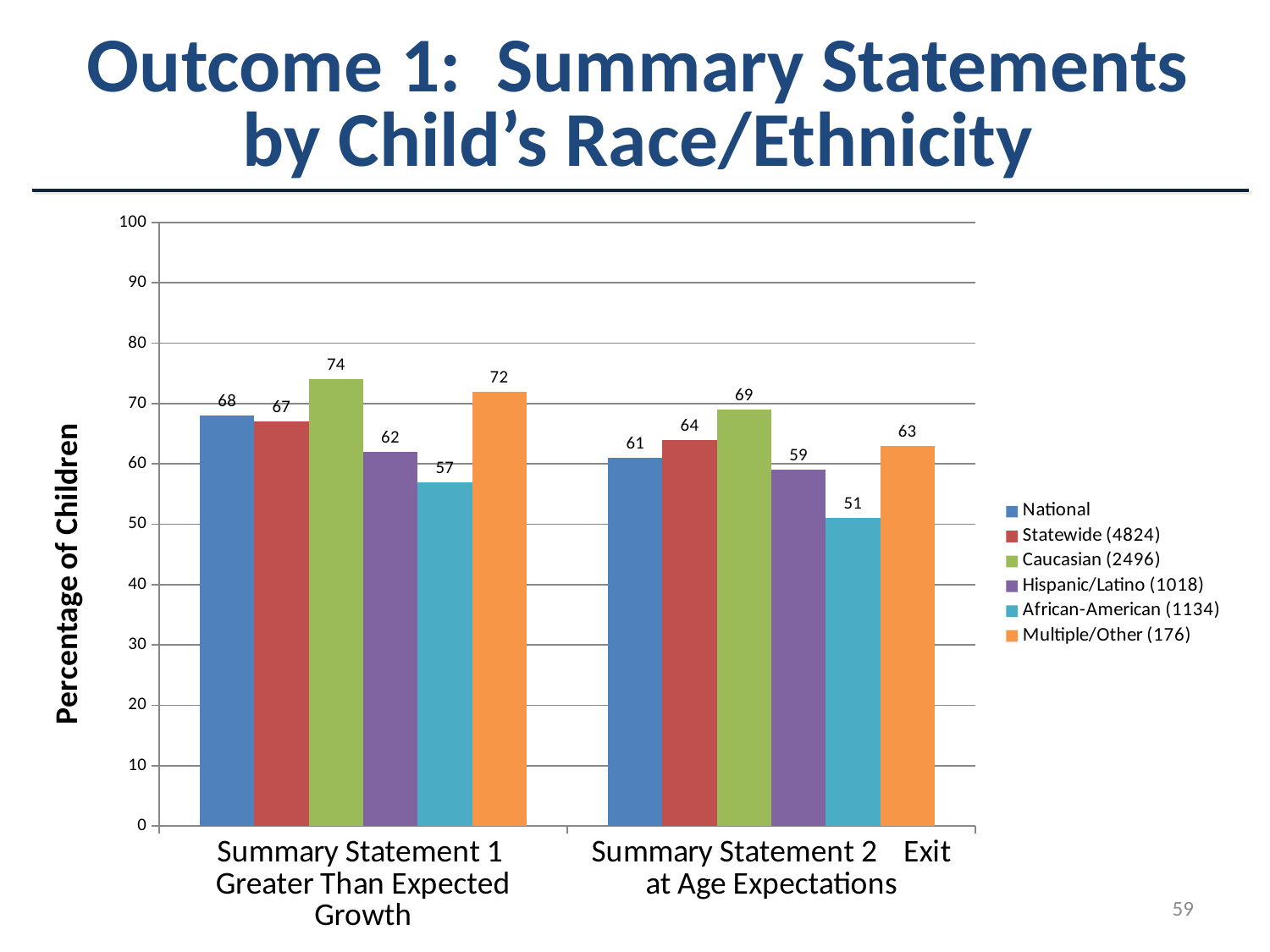
What is the difference between the Caucasian (2496) and African-American (1134) values in Summary Statement 1 Greater Than Expected Growth? 17 What is the label of the y axis? Percentage of Children Is the Hispanic/Latino (1018) value for Summary Statement 1 Greater Than Expected Growth greater or less than 70? less How many series does the legend list? 6 Which series has the highest value in Summary Statement 1 Greater Than Expected Growth? Caucasian (2496) Which series has the lowest value in Summary Statement 2 Exit at Age Expectations? African-American (1134) What is the value for African-American (1134) in Summary Statement 2 Exit at Age Expectations? 51 Which is larger in Summary Statement 2 Exit at Age Expectations: Statewide (4824) or Multiple/Other (176)? Statewide (4824) How many summary statement categories are shown on the x axis? 2 What is the National value for Summary Statement 2 Exit at Age Expectations? 61 What is the value for Caucasian (2496) in Summary Statement 1 Greater Than Expected Growth? 74 What kind of chart is shown on the slide? bar chart